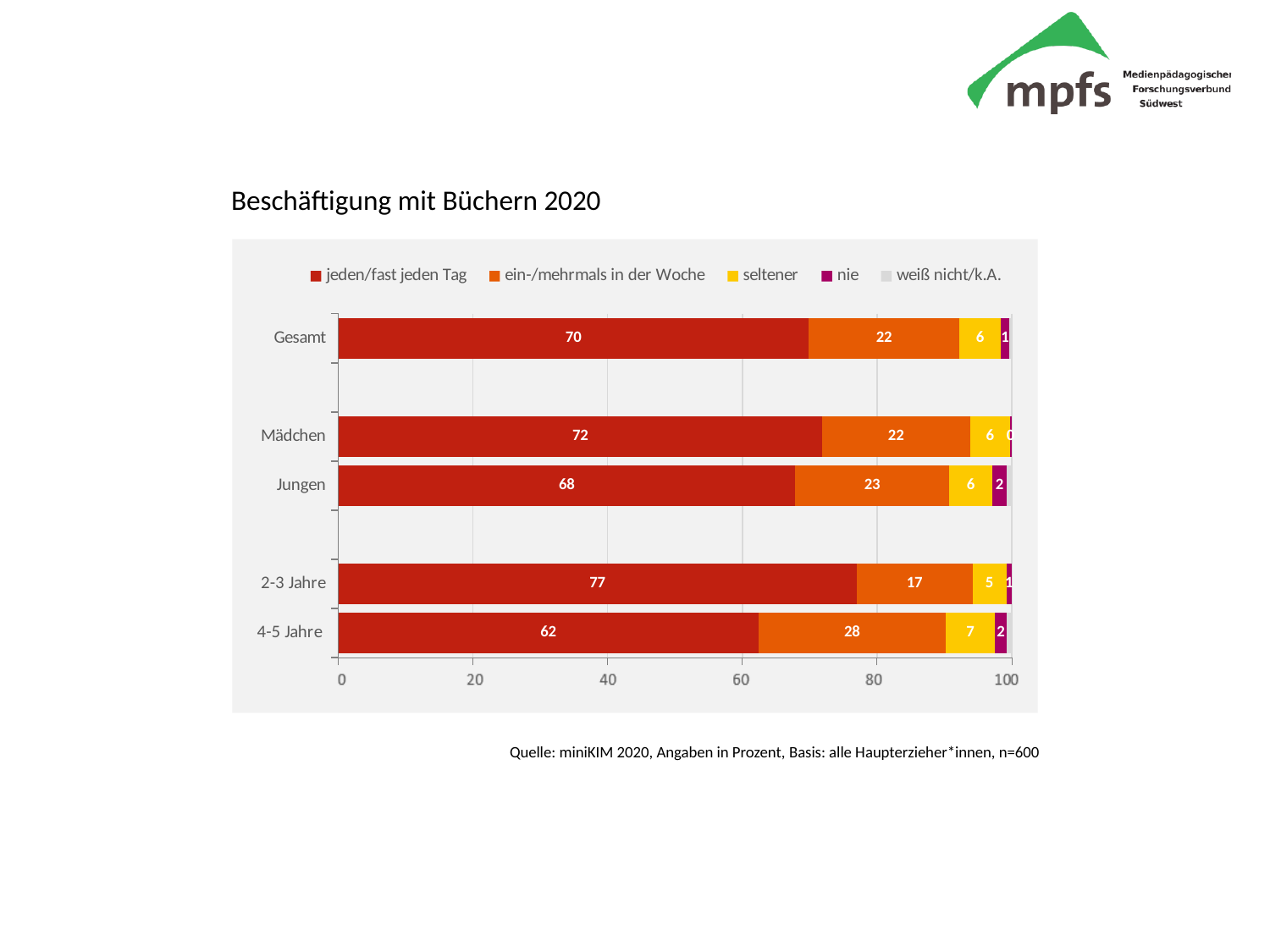
What is the value for "jeden/fast jeden Tag" for Gesamt? 70 What is the value for "ein-/mehrmals in der Woche" for 4-5 Jahre? 28 What is the title of the chart? Beschäftigung mit Büchern 2020 What is the difference between the "jeden/fast jeden Tag" values for 2-3 Jahre and 4-5 Jahre? 15 Which is larger, the "ein-/mehrmals in der Woche" value for Jungen or for Mädchen? Jungen What is the value for "nie" for Jungen? 2 Which category has the highest value for "jeden/fast jeden Tag"? 2-3 Jahre How many series does the legend list? 5 Which category has the lowest value for "jeden/fast jeden Tag"? 4-5 Jahre What kind of chart is shown? Stacked bar chart How many categories are shown on the y axis? 5 What is the value for "seltener" for 2-3 Jahre? 5